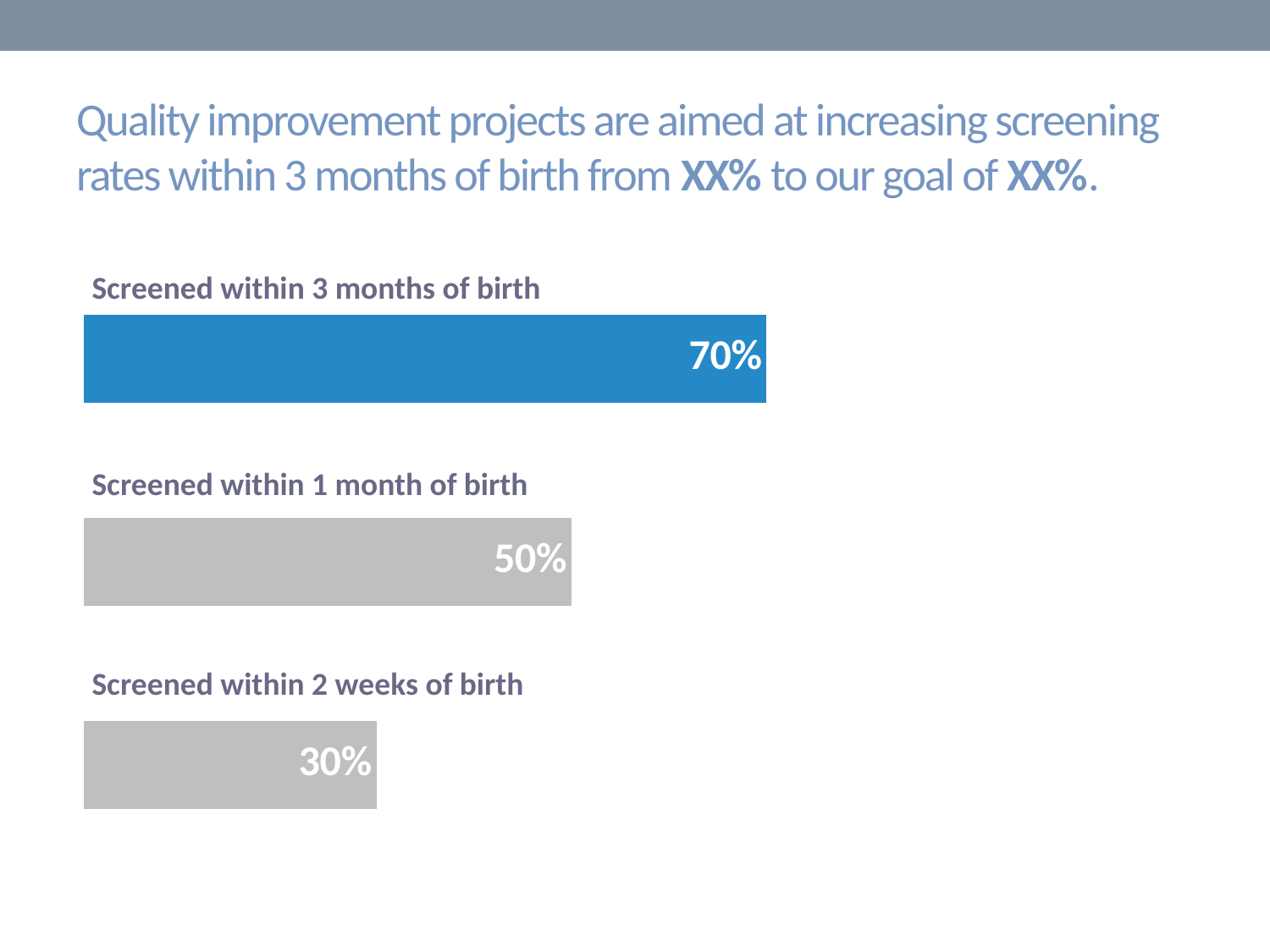
What kind of chart is shown on the slide? Bar chart What is the difference between the value for Screened within 3 months of birth and Screened within 1 month of birth? 20% Are the bars in the chart horizontal or vertical? Horizontal What is the value for Screened within 2 weeks of birth? 30% What is the difference between the value for Screened within 1 month of birth and Screened within 2 weeks of birth? 20% Which category has the highest value? Screened within 3 months of birth Which is larger, the value for Screened within 1 month of birth or Screened within 2 weeks of birth? Screened within 1 month of birth What is the value for Screened within 1 month of birth? 50% Which bar is coloured blue rather than grey? Screened within 3 months of birth How many categories are shown in the chart? 3 What is the value for Screened within 3 months of birth? 70% Which category has the lowest value? Screened within 2 weeks of birth